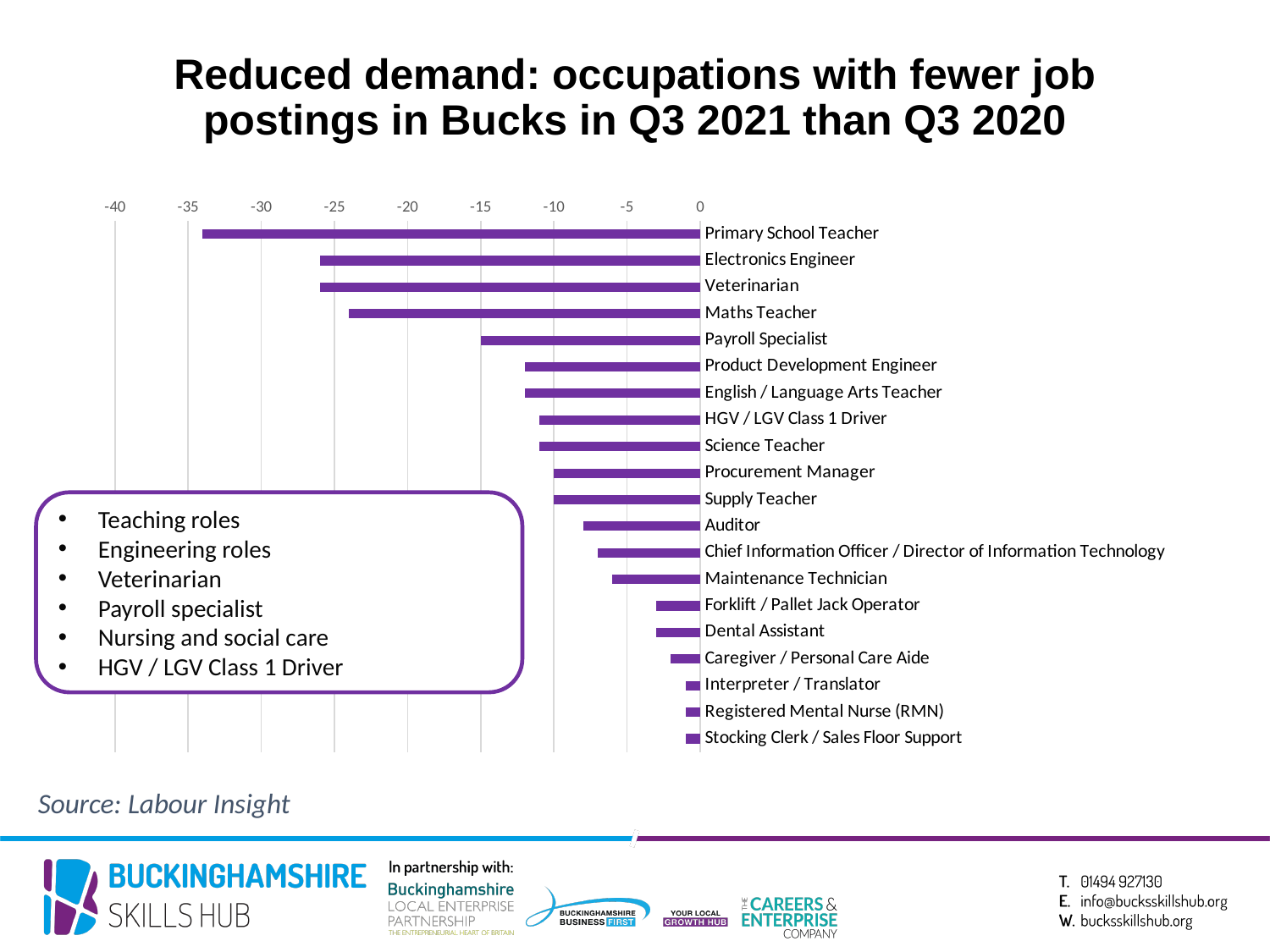
Is the value for Maintenance Technician greater or less than -10? greater What kind of chart is shown on the slide? bar chart Is the value for Primary School Teacher greater or less than -30? less Is the value for Forklift / Pallet Jack Operator greater or less than -5? greater Which occupation has the longest bar (the largest reduction in job postings)? Primary School Teacher What is the title of the slide containing the chart? Reduced demand: occupations with fewer job postings in Bucks in Q3 2021 than Q3 2020 Which bar is longer: Primary School Teacher or Maths Teacher? Primary School Teacher What is the lowest value shown on the chart's axis? -40 Which bar is longer: Payroll Specialist or Auditor? Payroll Specialist How many occupations are plotted in the chart? 20